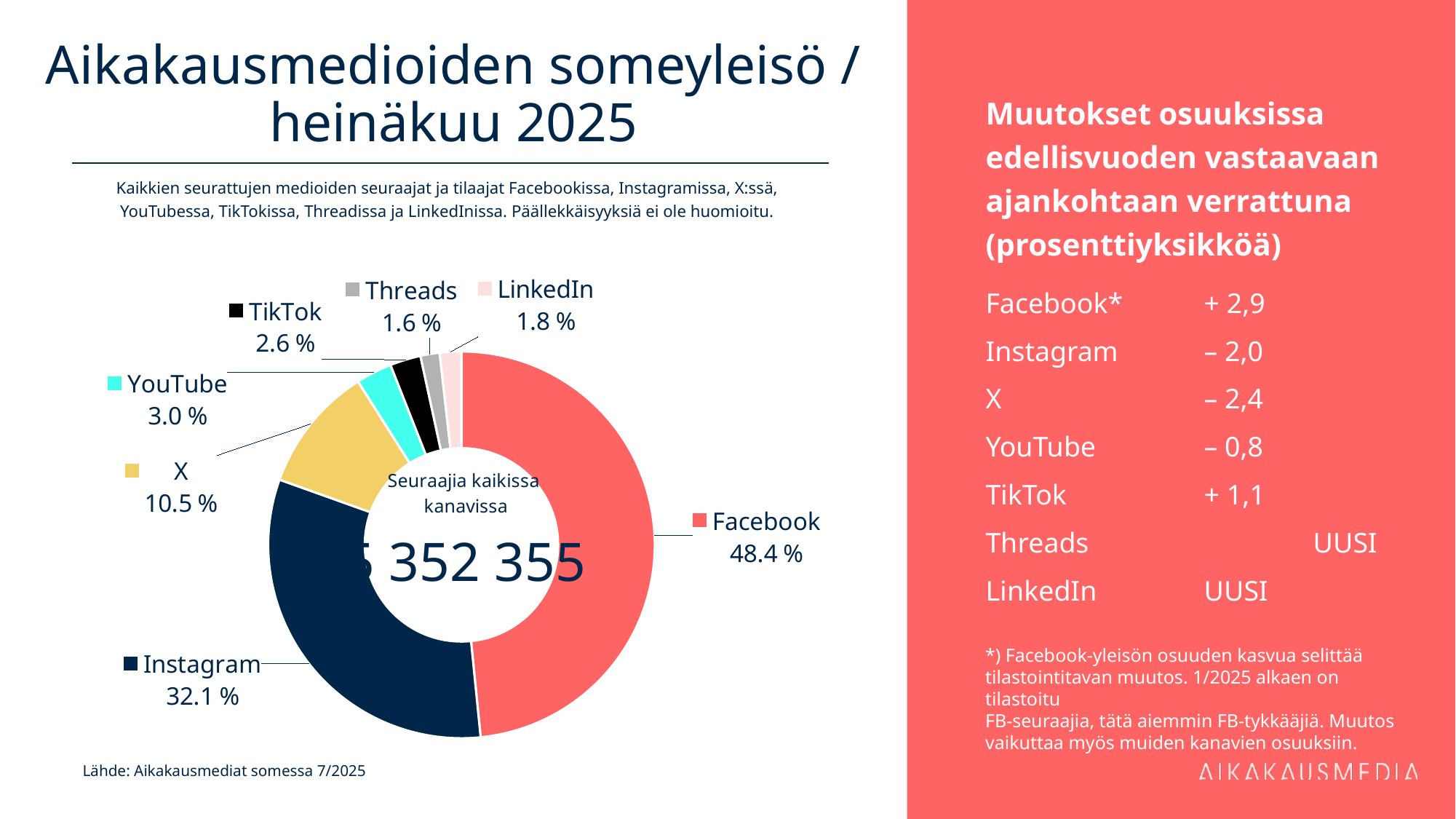
Which has a larger share, LinkedIn or Threads? LinkedIn What share does TikTok have in the chart? 2.6 % What share does Instagram have in the chart? 32.1 % What colour is the Facebook slice in the chart? Red (coral) Which has a larger share, YouTube or TikTok? YouTube What is the share for X in the chart? 10.5 % How many channels (slices) are shown in the chart? 7 How many percentage points larger is Facebook's share than Instagram's? 16.3 What share of the social media audience does Facebook have? 48.4 % Which channel has the smallest share in the chart? Threads Which channel has the largest share in the chart? Facebook What kind of chart is shown on the slide? Pie chart (donut)